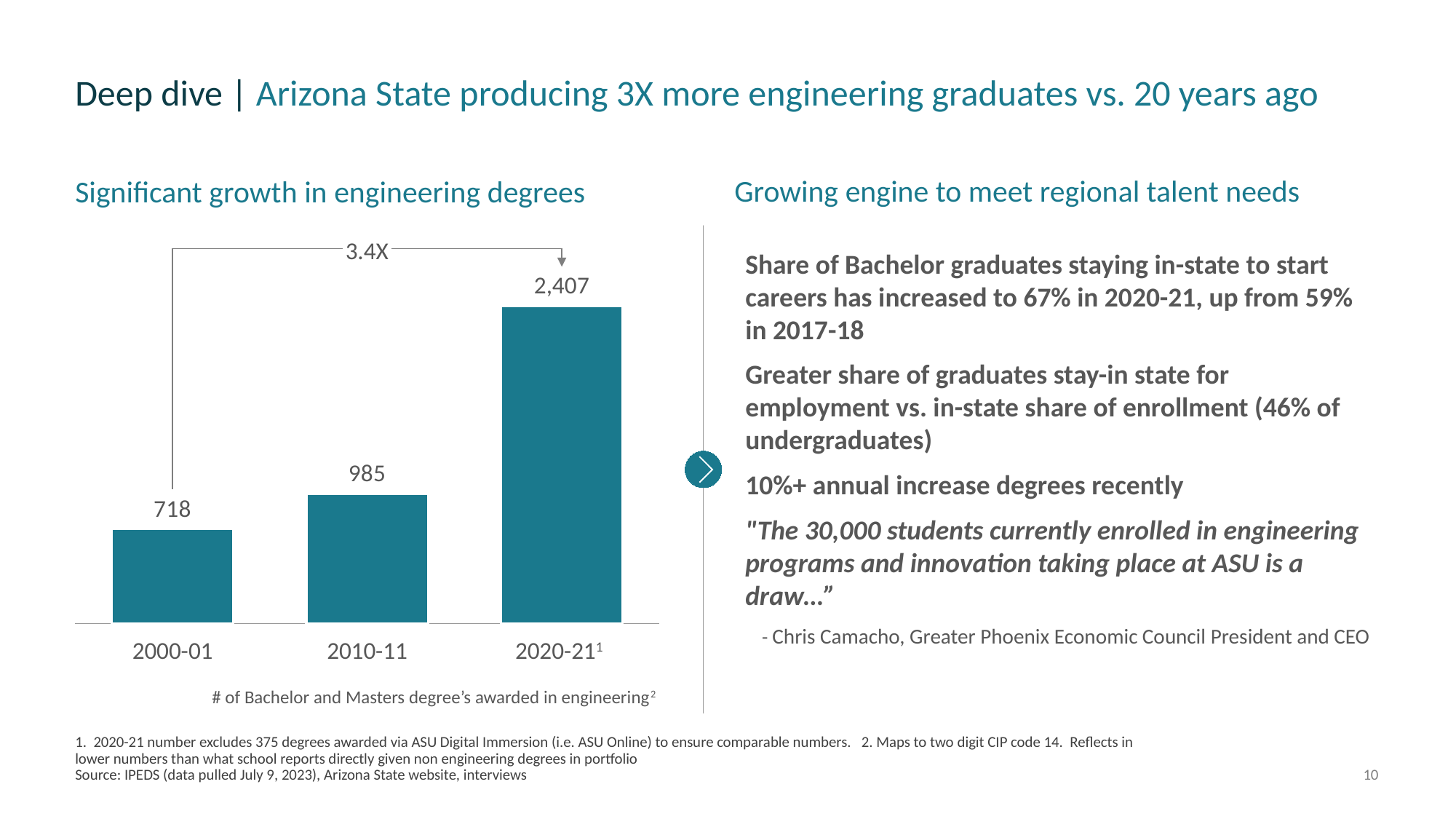
What is the number of engineering degrees awarded in 2020-21? 2,407 What growth multiple is annotated between 2000-01 and 2020-21 on the chart? 3.4X What kind of chart is shown on the slide? Bar chart What is the number of engineering degrees awarded in 2000-01? 718 Which year has the lowest number of engineering degrees awarded? 2000-01 What is the difference between the number of degrees awarded in 2010-11 and 2000-01? 267 What is the difference between the number of degrees awarded in 2020-21 and 2010-11? 1,422 Do the values rise or fall from 2000-01 to 2020-21? Rise Which is larger, the number of degrees awarded in 2010-11 or in 2000-01? 2010-11 What is the number of engineering degrees awarded in 2010-11? 985 How many time periods are shown in the chart? 3 Which year has the highest number of engineering degrees awarded? 2020-21